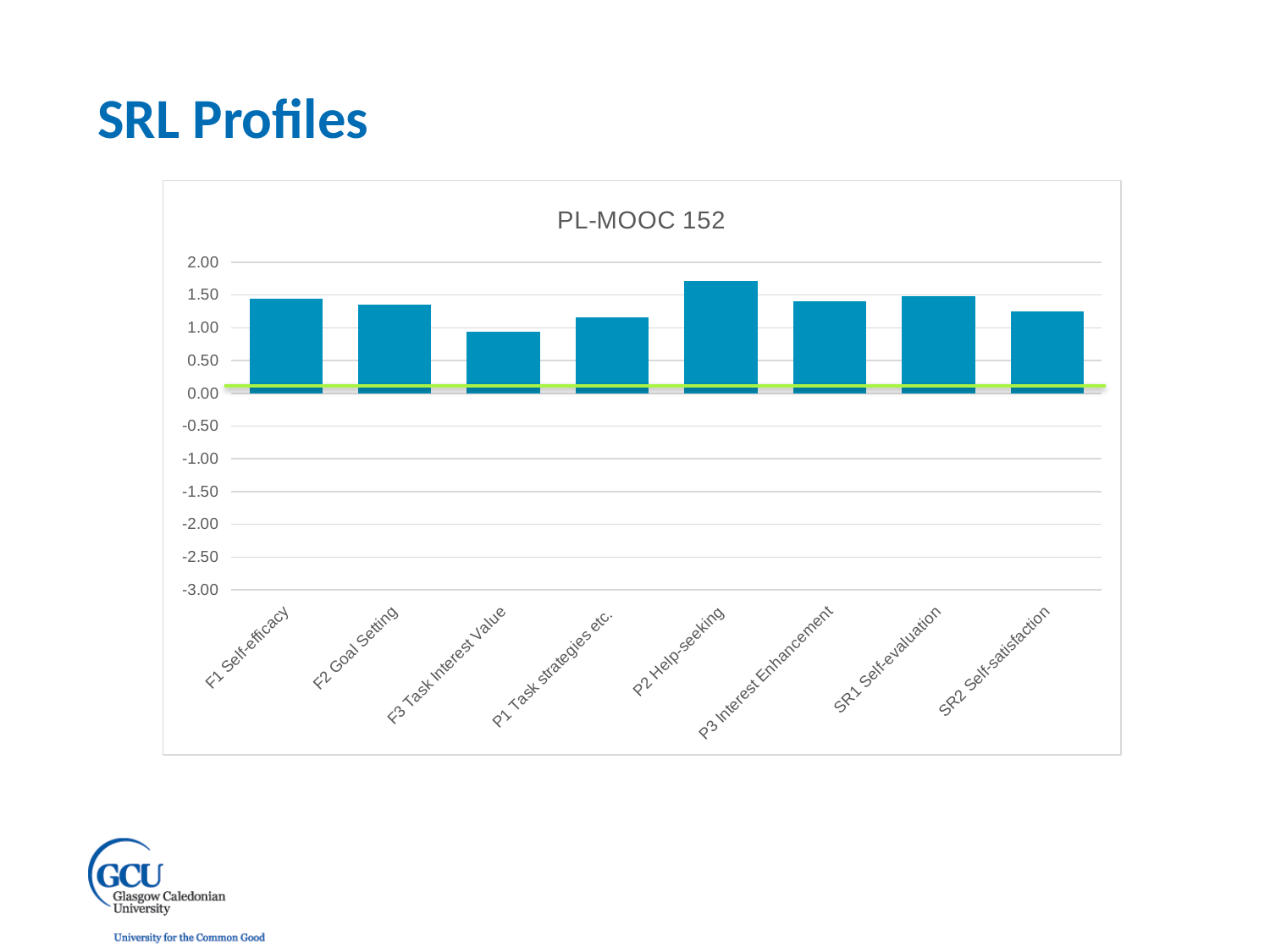
Which category has the lowest value in the chart? F3 Task Interest Value Is the value for F2 Goal Setting greater or less than 1.50? less Is the value for P2 Help-seeking greater or less than 1.50? greater What kind of chart is shown on the slide? bar chart Which category has the highest value in the chart? P2 Help-seeking Is the value for F3 Task Interest Value greater or less than 1.00? less How many categories are plotted on the x axis of the chart? 8 What is the lowest value shown on the y axis of the chart? -3.00 Which is larger, the value for F2 Goal Setting or the value for P1 Task strategies etc.? F2 Goal Setting What is the title of the chart? PL-MOOC 152 Which is larger, the value for P2 Help-seeking or the value for F3 Task Interest Value? P2 Help-seeking